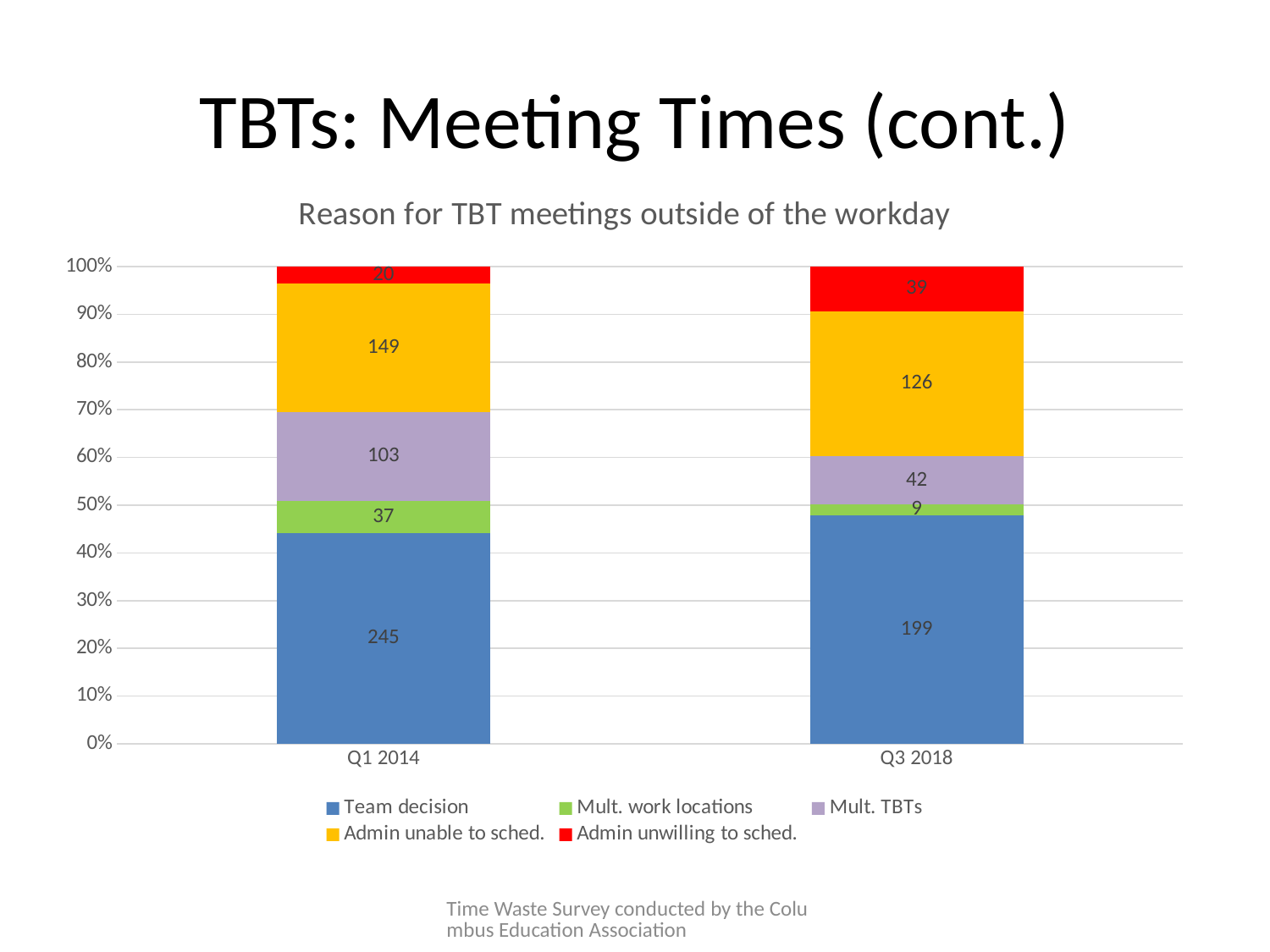
What is the value for Mult. TBTs in Q1 2014? 103 Which reason has the lowest value in Q1 2014? Admin unwilling to sched. What is the value for Mult. work locations in Q3 2018? 9 How many categories are shown on the x axis? 2 What is the value for Admin unable to sched. in Q3 2018? 126 What is the difference between the Admin unwilling to sched. values for Q3 2018 and Q1 2014? 19 How many series does the legend list? 5 Which reason has the highest value in Q3 2018? Team decision Which is larger, Mult. TBTs in Q1 2014 or Mult. TBTs in Q3 2018? Q1 2014 What is the value for Team decision in Q1 2014? 245 What kind of chart is shown on the slide? Stacked bar chart What is the total of all segments in the Q1 2014 bar? 554